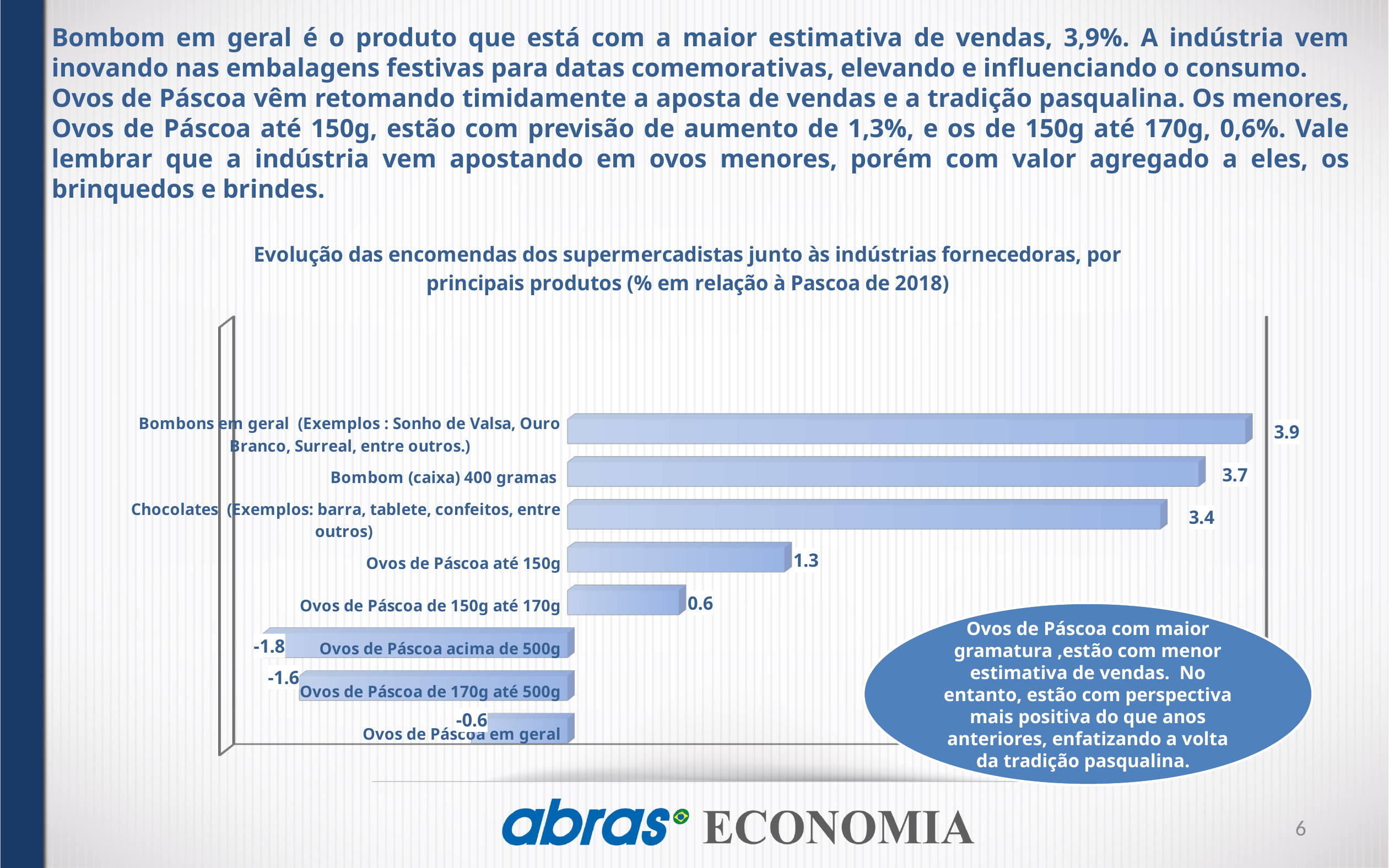
What is the value for Ovos de Páscoa até 150g? 1.3 What is the value for Ovos de Páscoa em geral? -0.6 How many categories have negative values? 3 Which category has the lowest value? Ovos de Páscoa acima de 500g What is the difference between the values for Bombons em geral and Chocolates? 0.5 Which category has the highest value? Bombons em geral (Exemplos : Sonho de Valsa, Ouro Branco, Surreal, entre outros.) Which is larger, the value for Ovos de Páscoa de 170g até 500g or the value for Ovos de Páscoa em geral? Ovos de Páscoa em geral What is the value for Ovos de Páscoa acima de 500g? -1.8 How many categories are shown in the chart? 8 What kind of chart is shown on the slide? bar chart What is the difference between the values for Ovos de Páscoa até 150g and Ovos de Páscoa de 150g até 170g? 0.7 What is the value for Bombom (caixa) 400 gramas? 3.7